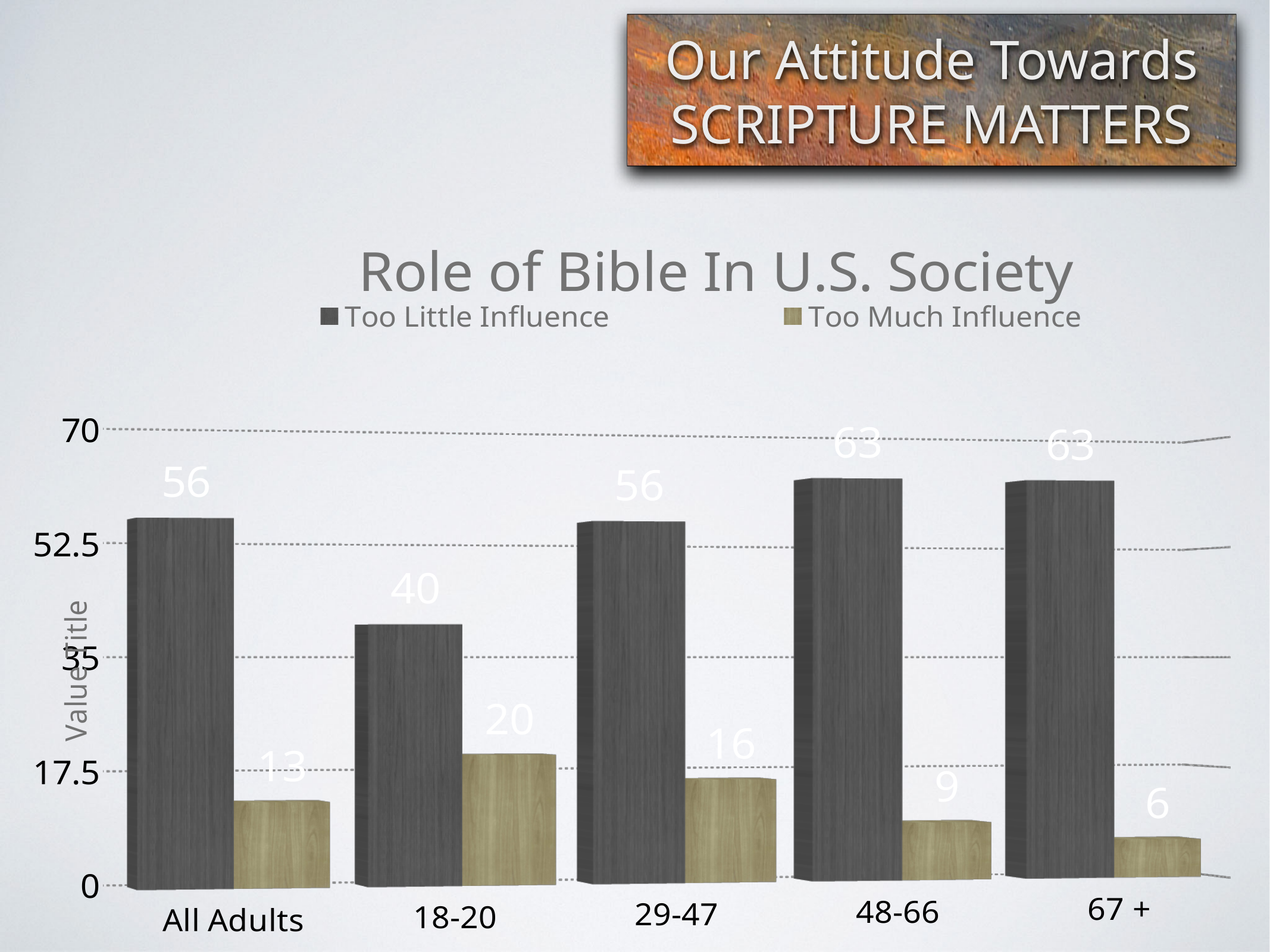
What is the value for Too Much Influence for the 67 + group? 6 Which is larger, Too Little Influence for All Adults or Too Little Influence for 48-66? 48-66 What is the difference in Too Much Influence between the 29-47 group and the 67 + group? 10 What is the value for Too Much Influence for All Adults? 13 Which category has the highest value for Too Much Influence? 18-20 What kind of chart is shown? bar chart What is the difference between Too Little Influence and Too Much Influence for the 48-66 group? 54 What is the value for Too Little Influence for the 18-20 group? 40 What is the title of the chart? Role of Bible In U.S. Society Which category has the lowest value for Too Little Influence? 18-20 How many categories are shown on the x axis? 5 How many series does the legend list? 2